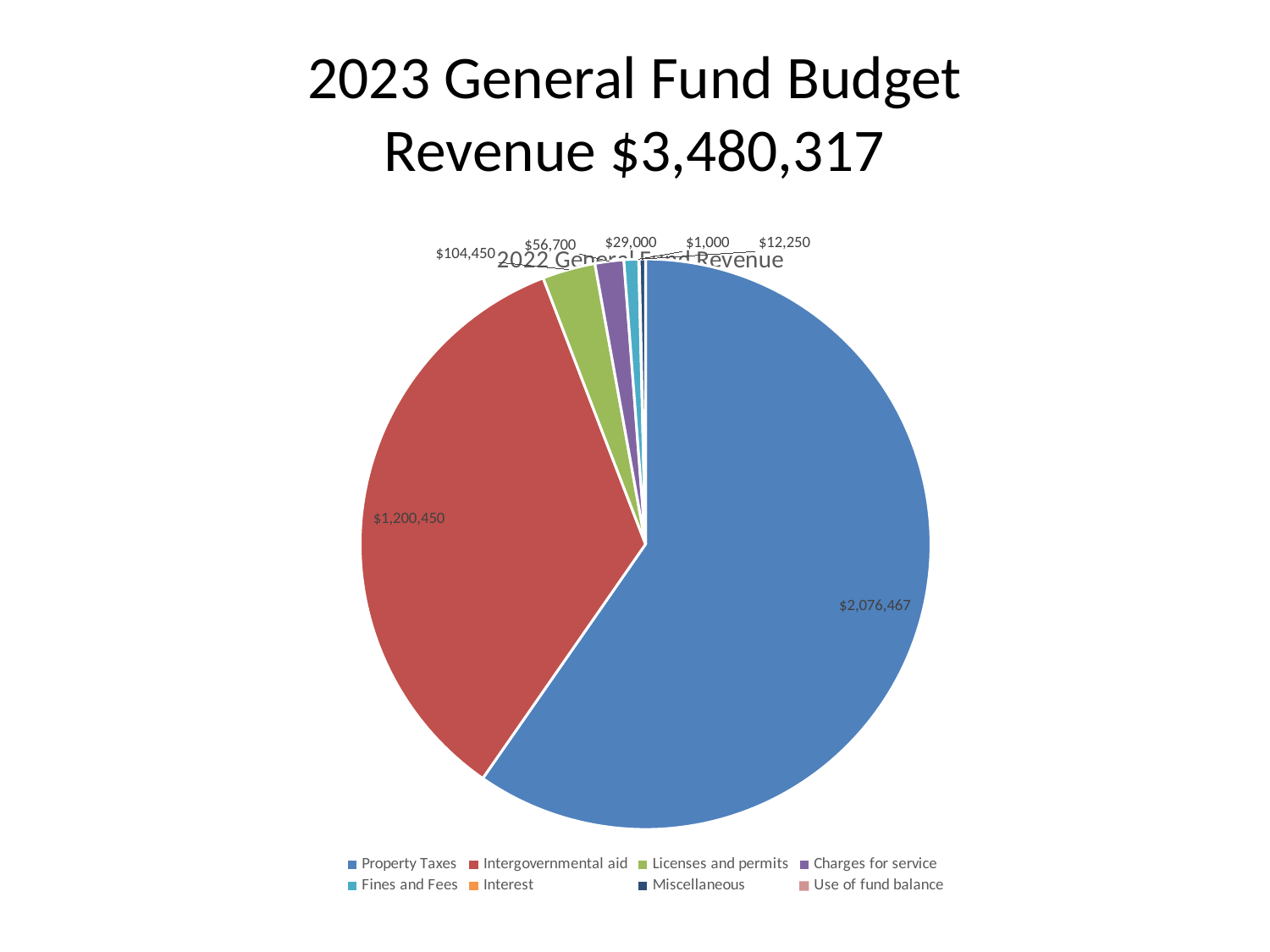
Which category has the largest slice of the pie? Property Taxes What is the value of the Property Taxes slice? $2,076,467 What is the value of the Charges for service slice? $56,700 What is the difference between the Property Taxes value and the Intergovernmental aid value? $876,017 What type of chart is shown on the slide? Pie chart What total revenue figure is stated in the slide title? $3,480,317 What is the value of the Intergovernmental aid slice? $1,200,450 Which of the labelled slices has the smallest value? Interest ($1,000) What is the value of the Fines and Fees slice? $29,000 How many categories are listed in the chart legend? 8 Which is larger, Licenses and permits or Charges for service? Licenses and permits What is the value of the Licenses and permits slice? $104,450